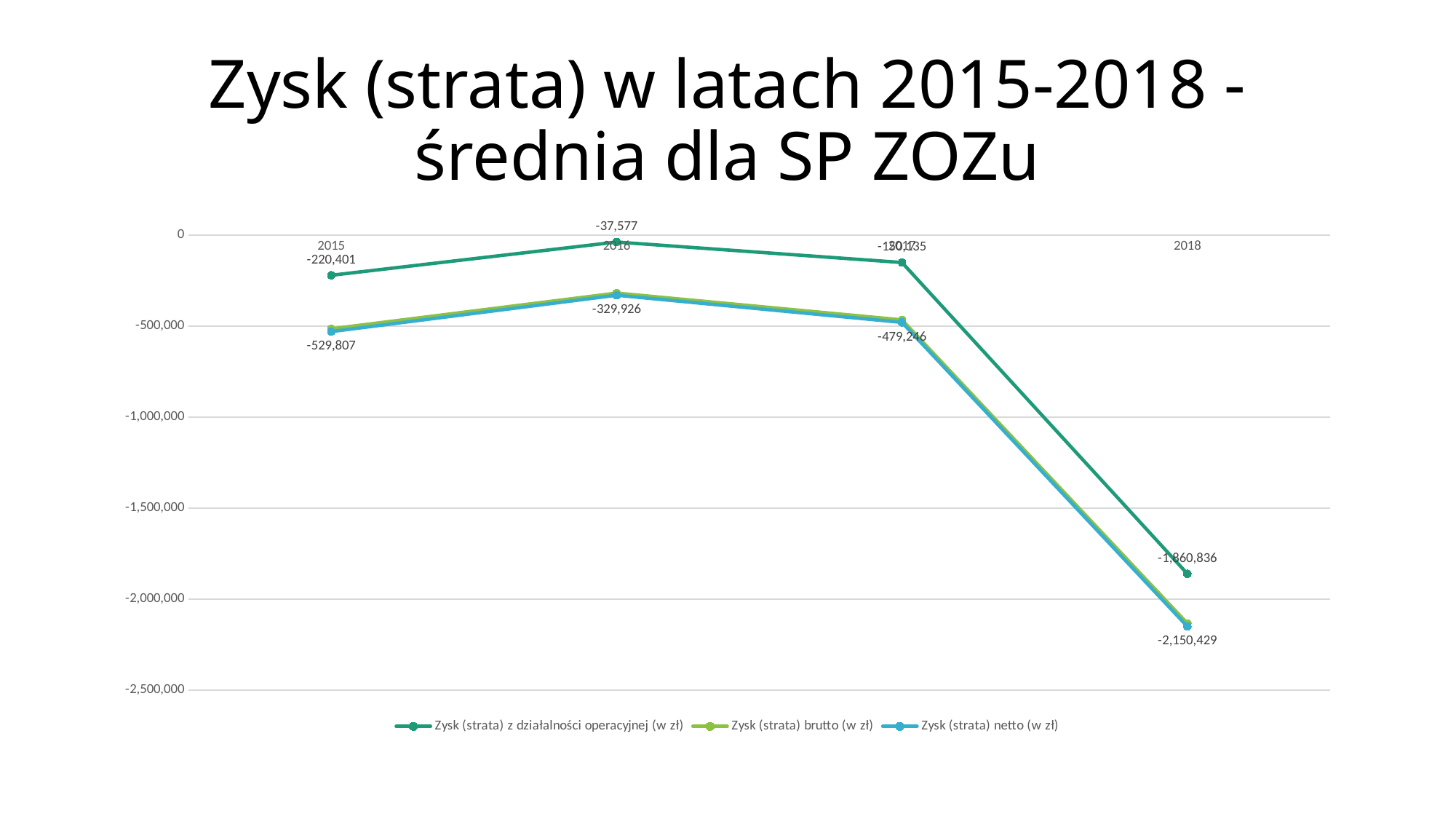
What is the value of Zysk (strata) z działalności operacyjnej (w zł) in 2015? -220,401 How many years are plotted along the x axis? 4 In which year is Zysk (strata) z działalności operacyjnej (w zł) lowest? 2018 Which is higher in 2018: Zysk (strata) z działalności operacyjnej (w zł) or Zysk (strata) netto (w zł)? Zysk (strata) z działalności operacyjnej (w zł) By how much did Zysk (strata) z działalności operacyjnej (w zł) change from 2015 to 2016? 182,824 What is the value of Zysk (strata) z działalności operacyjnej (w zł) in 2016? -37,577 What kind of chart is shown on the slide? line chart Is the value for Zysk (strata) netto (w zł) in 2018 greater or less than -2,000,000? less What is the value of Zysk (strata) z działalności operacyjnej (w zł) in 2018? -1,860,836 Is the value for Zysk (strata) brutto (w zł) in 2015 greater or less than -1,000,000? greater In which year is Zysk (strata) z działalności operacyjnej (w zł) highest? 2016 How many series does the legend list? 3